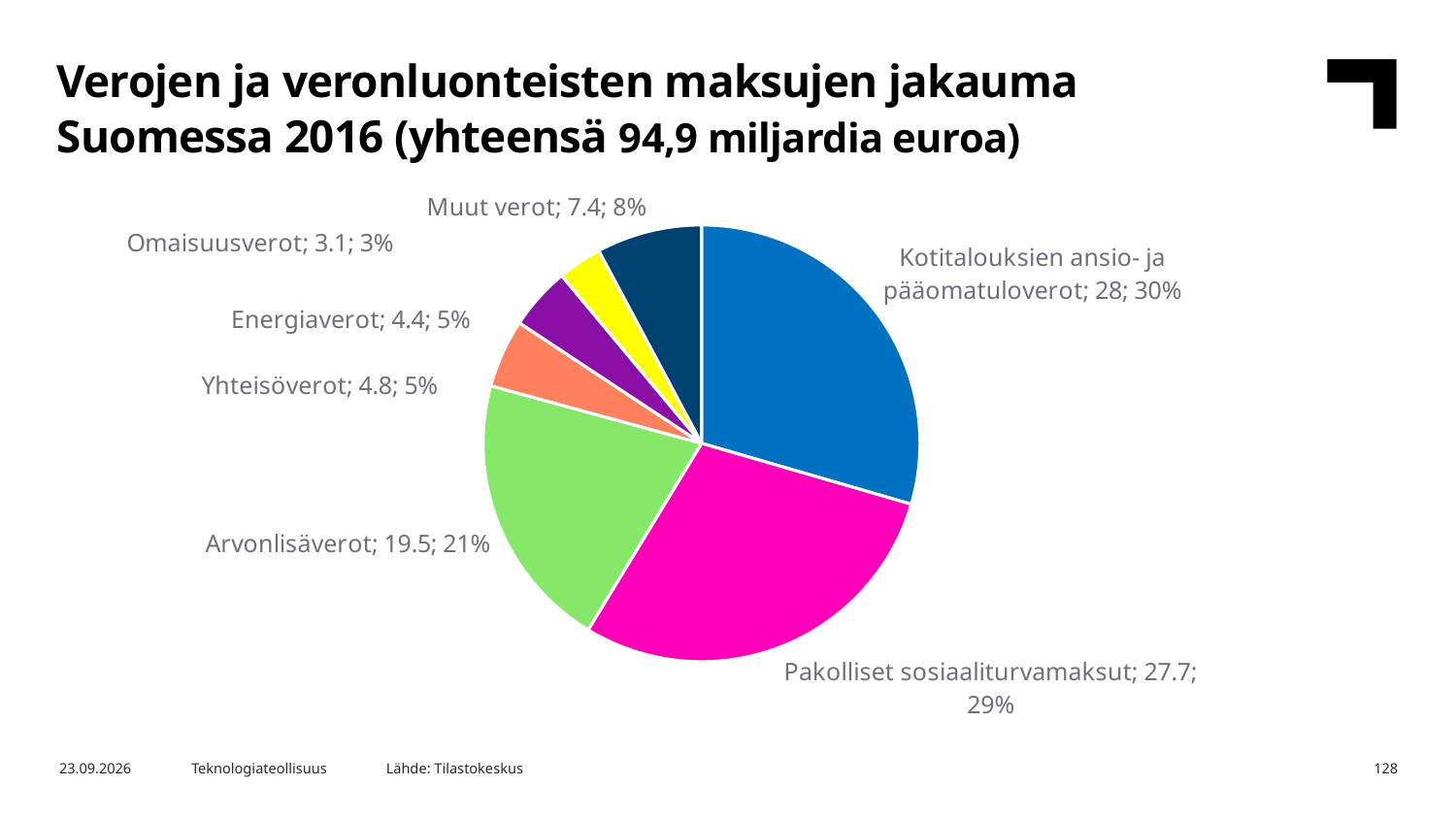
What is the value shown for Pakolliset sosiaaliturvamaksut? 27.7 According to the chart title, what is the total amount of taxes and tax-like payments in Finland in 2016? 94,9 miljardia euroa What share of the pie does Muut verot represent? 8% What kind of chart is shown on the slide? pie chart What is the difference between the values for Arvonlisäverot and Yhteisöverot? 14.7 How many slices does the pie chart have? 7 What is the value shown for Arvonlisäverot? 19.5 Which is larger, the value for Muut verot or the value for Yhteisöverot? Muut verot Which category has the smallest slice of the pie? Omaisuusverot What is the value shown for Energiaverot? 4.4 Which category has the largest slice of the pie? Kotitalouksien ansio- ja pääomatuloverot What share of the pie does Arvonlisäverot represent? 21%